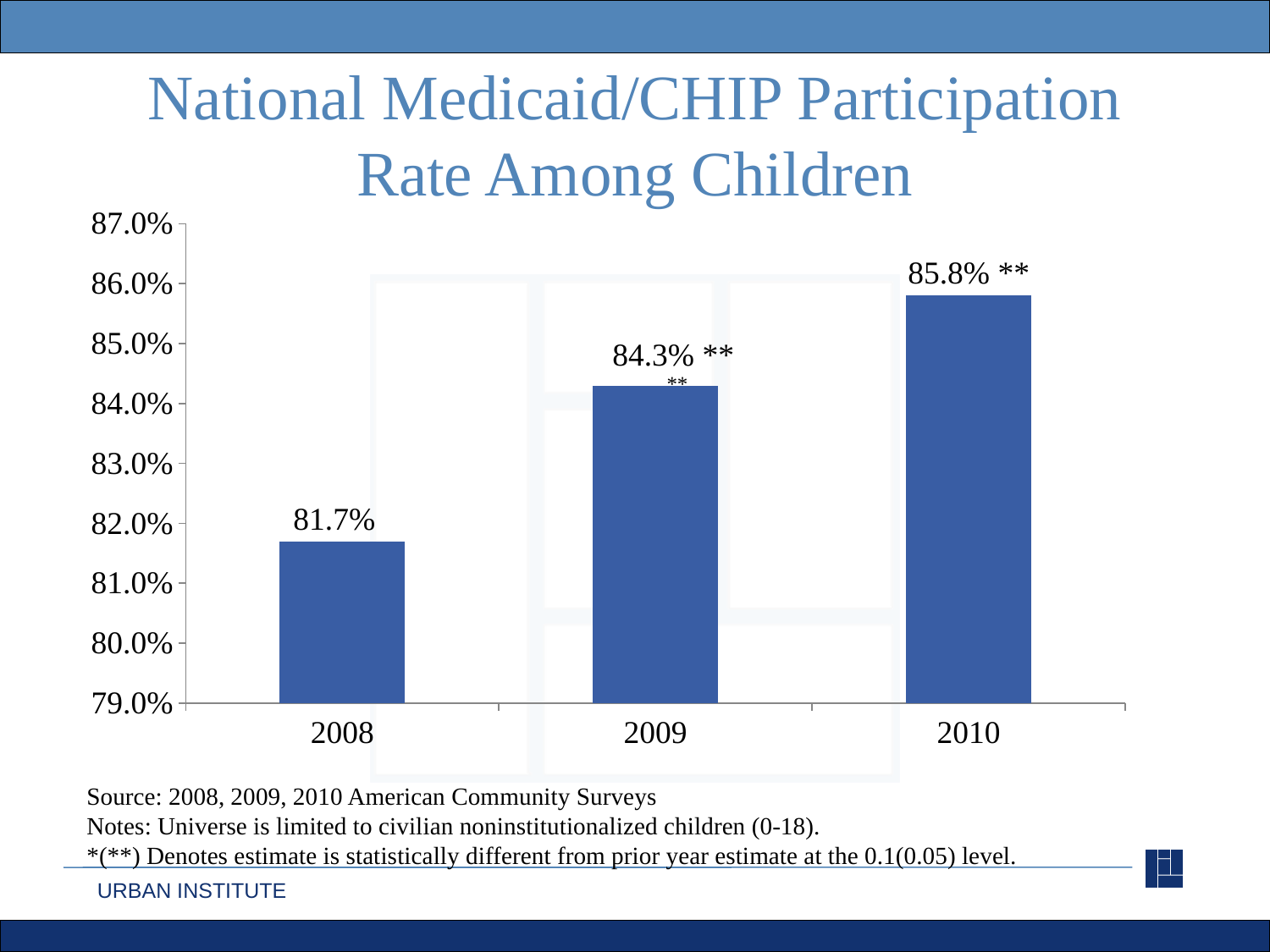
What is the Medicaid/CHIP participation rate among children in 2008? 81.7% By how many percentage points did the participation rate increase from 2008 to 2010? 4.1 percentage points Which year has the lowest participation rate? 2008 Is the participation rate higher in 2009 or in 2008? 2009 How many years are shown on the chart? 3 What is the Medicaid/CHIP participation rate among children in 2009? 84.3% By how many percentage points did the participation rate increase from 2009 to 2010? 1.5 percentage points What kind of chart is shown on the slide? Bar chart Is the value for 2009 greater or less than 84.0%? greater Does the participation rate rise or fall from 2008 to 2010? Rises What is the Medicaid/CHIP participation rate among children in 2010? 85.8% Which year has the highest participation rate? 2010